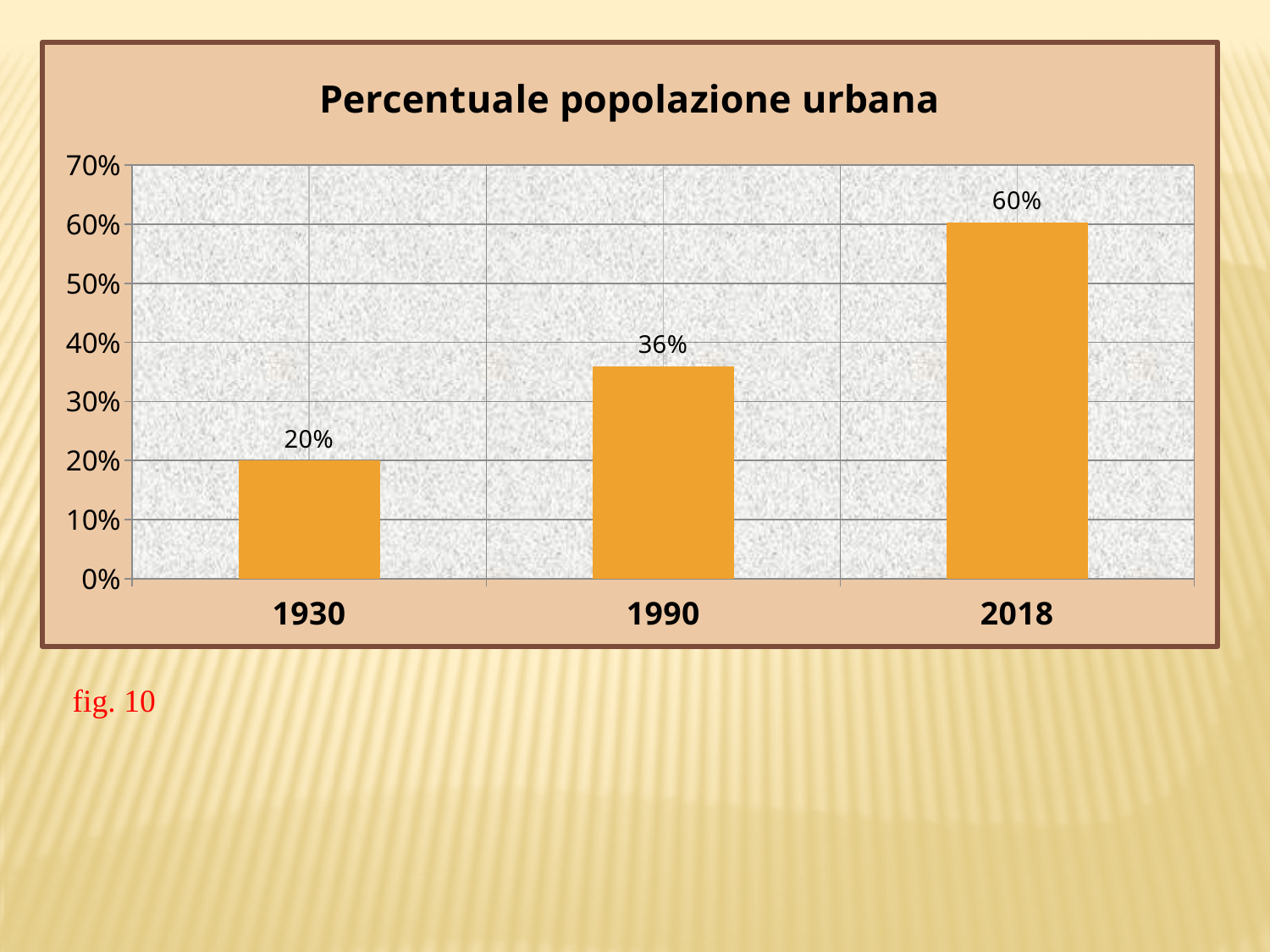
What is the difference between the values for 1990 and 1930? 16% Which is larger, the value for 1990 or the value for 2018? 2018 Do the values rise or fall from 1930 to 2018? rise What is the value for 1990? 36% Is the value for 1990 greater or less than 40%? less Which year has the highest percentage of urban population? 2018 How many years are shown on the x axis? 3 What is the value for 1930? 20% What is the value for 2018? 60% What is the difference between the values for 2018 and 1930? 40% Which year has the lowest percentage of urban population? 1930 What kind of chart is shown on the slide? bar chart